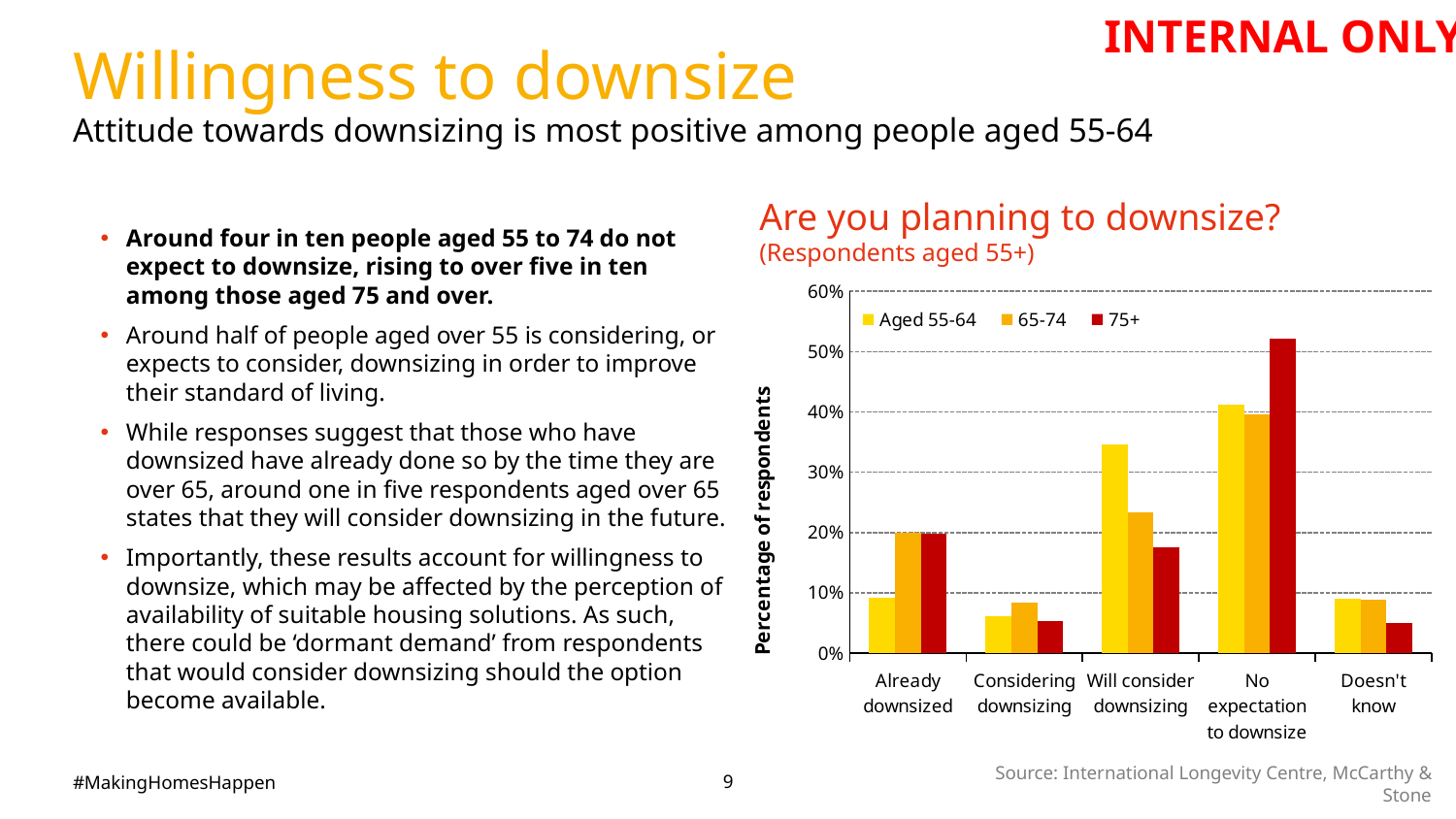
Is the value for 75+ in the 'Doesn't know' category greater or less than 10%? less For the Aged 55-64 series, which category has the lowest value? Considering downsizing What kind of chart is shown on the slide? Bar chart How many categories are shown on the x axis of the chart? 5 Is the value for 75+ in the 'No expectation to downsize' category greater or less than 40%? greater Is the value for Aged 55-64 in the 'Will consider downsizing' category greater or less than 30%? greater In the 'No expectation to downsize' category, which series has the larger value: 65-74 or 75+? 75+ What is the title of the chart? Are you planning to downsize? How many series does the legend of the chart list? 3 For the 75+ series, which category has the highest value? No expectation to downsize In the 'Will consider downsizing' category, which series has the larger value: Aged 55-64 or 75+? Aged 55-64